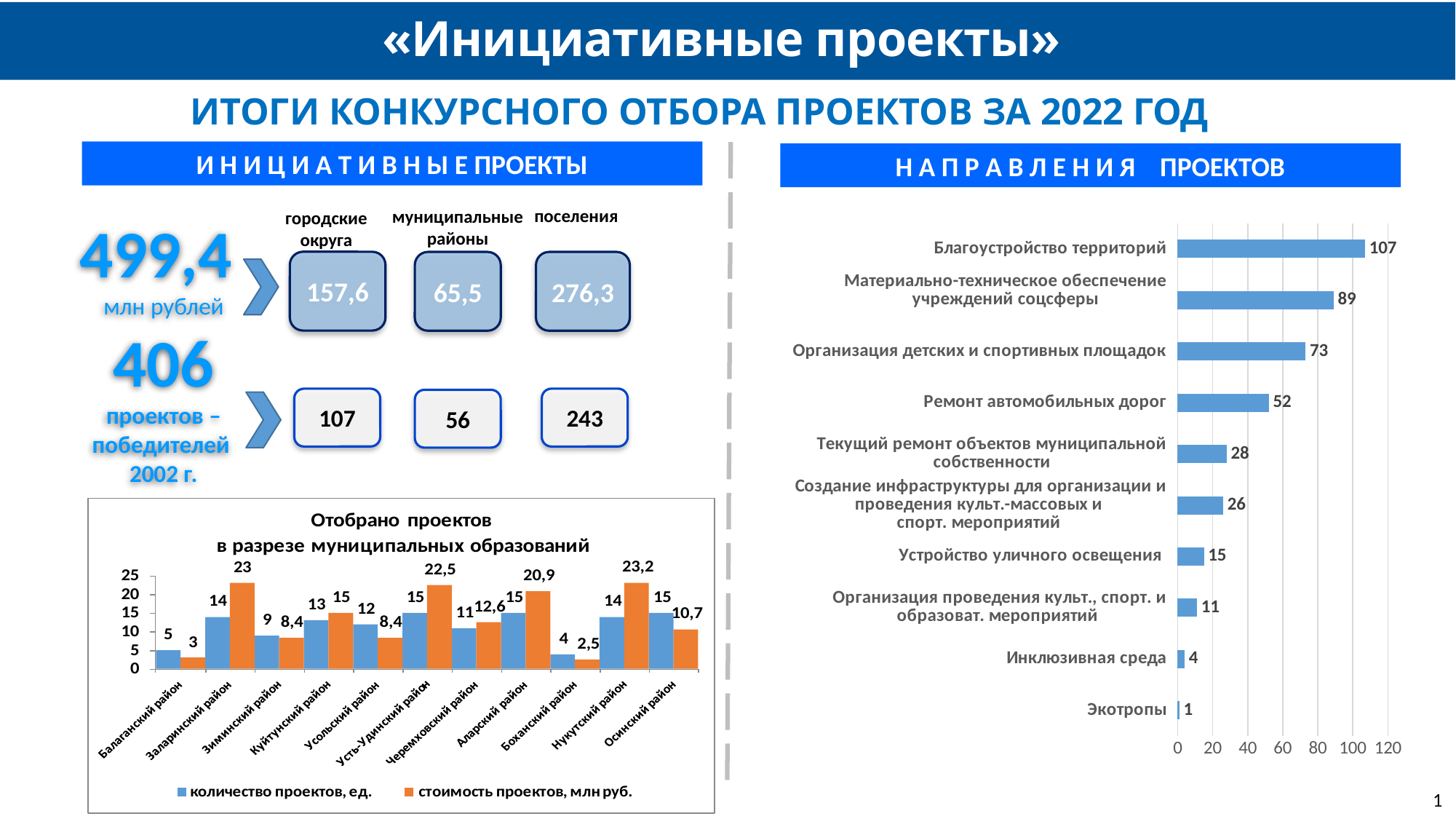
What type of chart is shown on the right side of the slide under 'Направления проектов'? Bar chart In the chart 'Отобрано проектов в разрезе муниципальных образований', how many districts are shown on the x axis? 11 In the bar chart on the right side of the slide (Направления проектов), which category has the highest value? Благоустройство территорий In the bar chart on the right side of the slide (Направления проектов), what is the value for 'Ремонт автомобильных дорог'? 52 In the chart 'Отобрано проектов в разрезе муниципальных образований', which is larger for Аларский район: 'количество проектов, ед.' or 'стоимость проектов, млн руб.'? стоимость проектов, млн руб. In the chart 'Отобрано проектов в разрезе муниципальных образований', which district has the highest 'стоимость проектов, млн руб.'? Нукутский район In the chart 'Отобрано проектов в разрезе муниципальных образований', what is the difference between 'стоимость проектов, млн руб.' for Заларинский район and Балаганский район? 20 In the chart 'Отобрано проектов в разрезе муниципальных образований', which district has the lowest 'стоимость проектов, млн руб.'? Боханский район In the chart 'Отобрано проектов в разрезе муниципальных образований', how many series does the legend list? 2 In the bar chart on the right side of the slide (Направления проектов), what is the difference between 'Благоустройство территорий' and 'Организация детских и спортивных площадок'? 34 In the chart 'Отобрано проектов в разрезе муниципальных образований', what is the value of 'стоимость проектов, млн руб.' for Усть-Удинский район? 22,5 In the chart 'Отобрано проектов в разрезе муниципальных образований', what is the value of 'количество проектов, ед.' for Заларинский район? 14